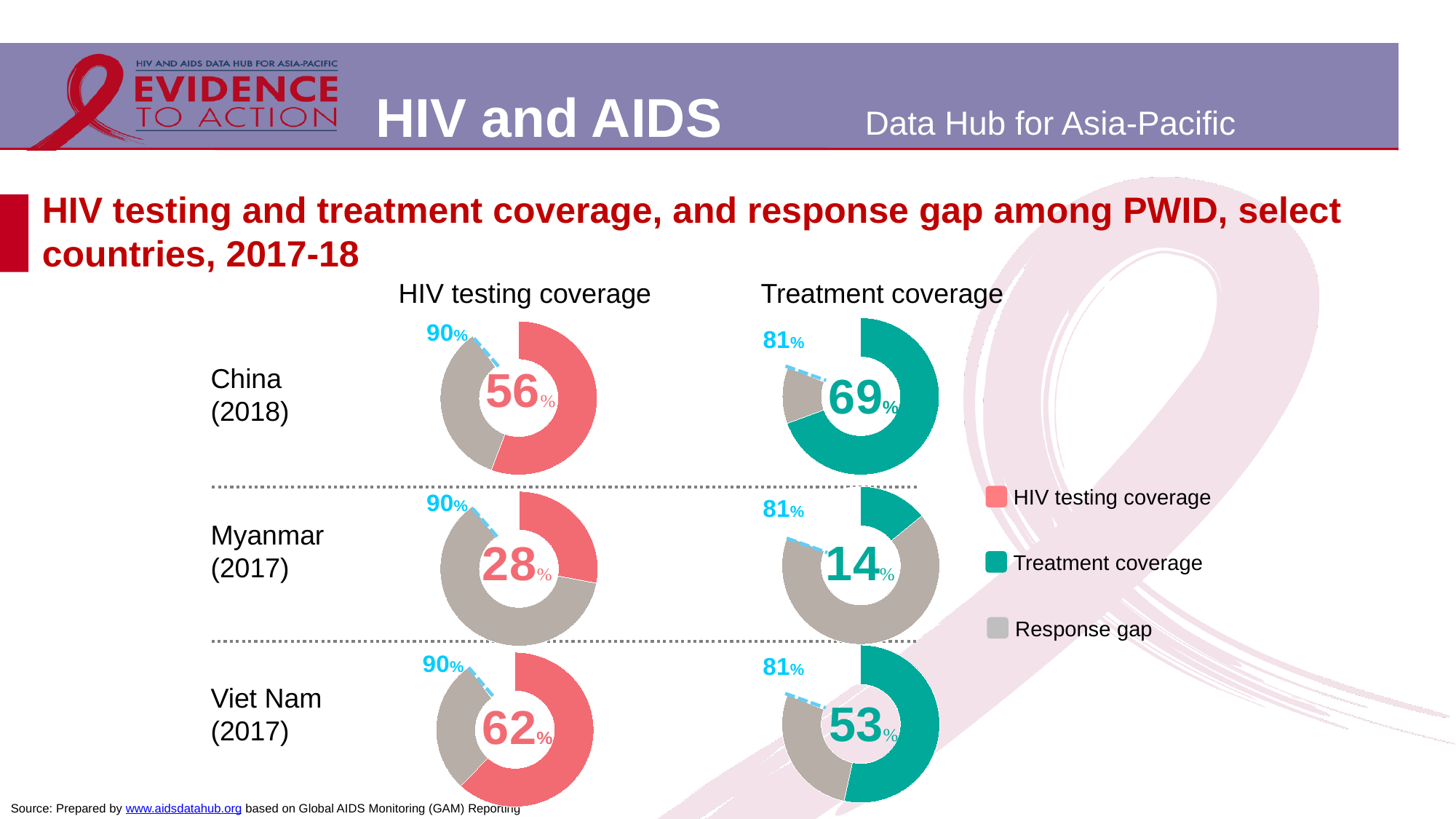
What kind of chart is used to show the coverage values? Donut (pie) chart How many countries are shown in the charts? 3 What target percentage is marked on the treatment coverage charts? 81% How many entries does the legend list? 3 What is the HIV testing coverage among PWID in Viet Nam (2017)? 62% What is the HIV testing coverage among PWID in China (2018)? 56% What is the treatment coverage among PWID in Myanmar (2017)? 14% Which country has the lowest treatment coverage among PWID? Myanmar (2017) What is the treatment coverage among PWID in China (2018)? 69% Is the treatment coverage for Viet Nam (2017) larger or smaller than its HIV testing coverage? smaller Which country has the highest HIV testing coverage among PWID? Viet Nam (2017) What is the difference between the HIV testing coverage and the treatment coverage for Myanmar (2017)? 14%